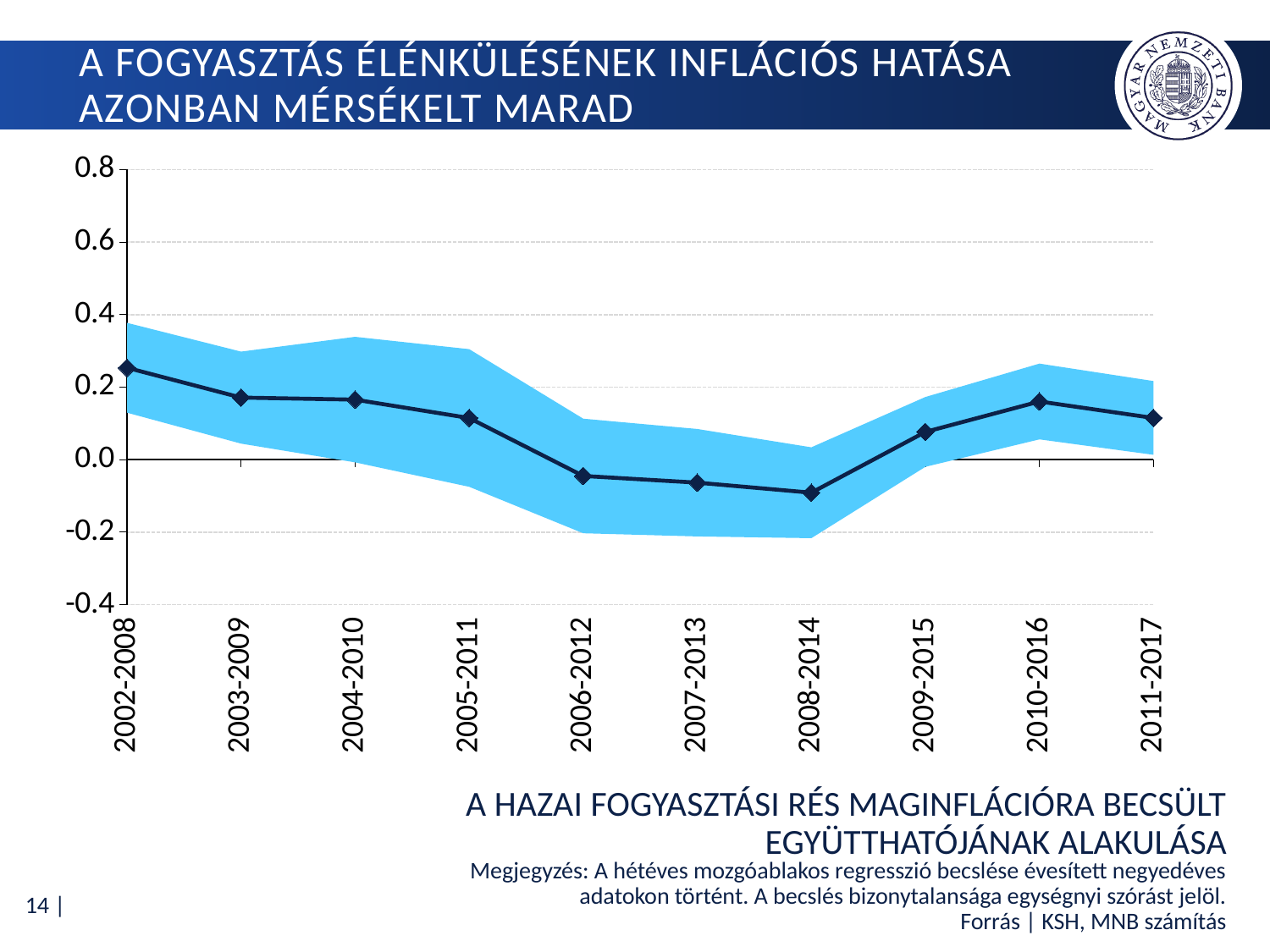
Is the value for 2008-2014 greater or less than 0.0? less Which is larger, the value for 2002-2008 or the value for 2008-2014? 2002-2008 What kind of chart is shown on the slide? line chart What is the title of the chart? A hazai fogyasztási rés maginflációra becsült együtthatójának alakulása Which period has the highest value of the plotted line? 2002-2008 How many periods are plotted along the x axis? 10 Does the plotted line rise or fall from 2002-2008 to 2008-2014? fall Which period has the lowest value of the plotted line? 2008-2014 Is the value for 2010-2016 greater or less than 0.0? greater Is the value for 2002-2008 greater or less than 0.2? greater Which is larger, the value for 2006-2012 or the value for 2009-2015? 2009-2015